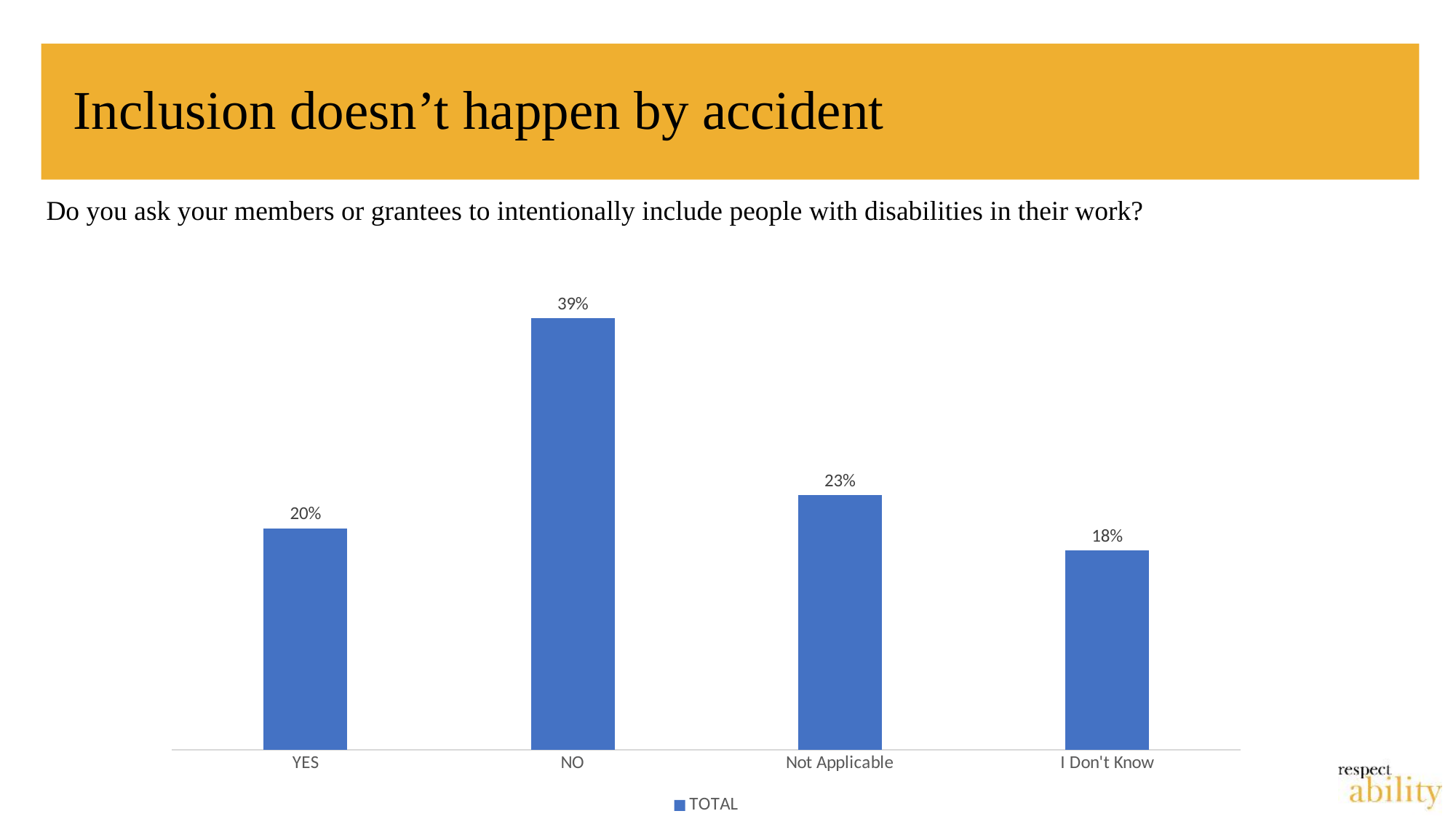
What is the value for I Don't Know? 18% Which is larger, the value for YES or the value for Not Applicable? Not Applicable How many categories are shown on the x axis? 4 What is the value for YES? 20% Which category has the lowest value? I Don't Know What is the value for NO? 39% What kind of chart is shown on the slide? Bar chart What series name does the legend list? TOTAL What is the value for Not Applicable? 23% What is the difference between the values for Not Applicable and I Don't Know? 5% Which category has the highest value? NO What is the difference between the values for NO and YES? 19%